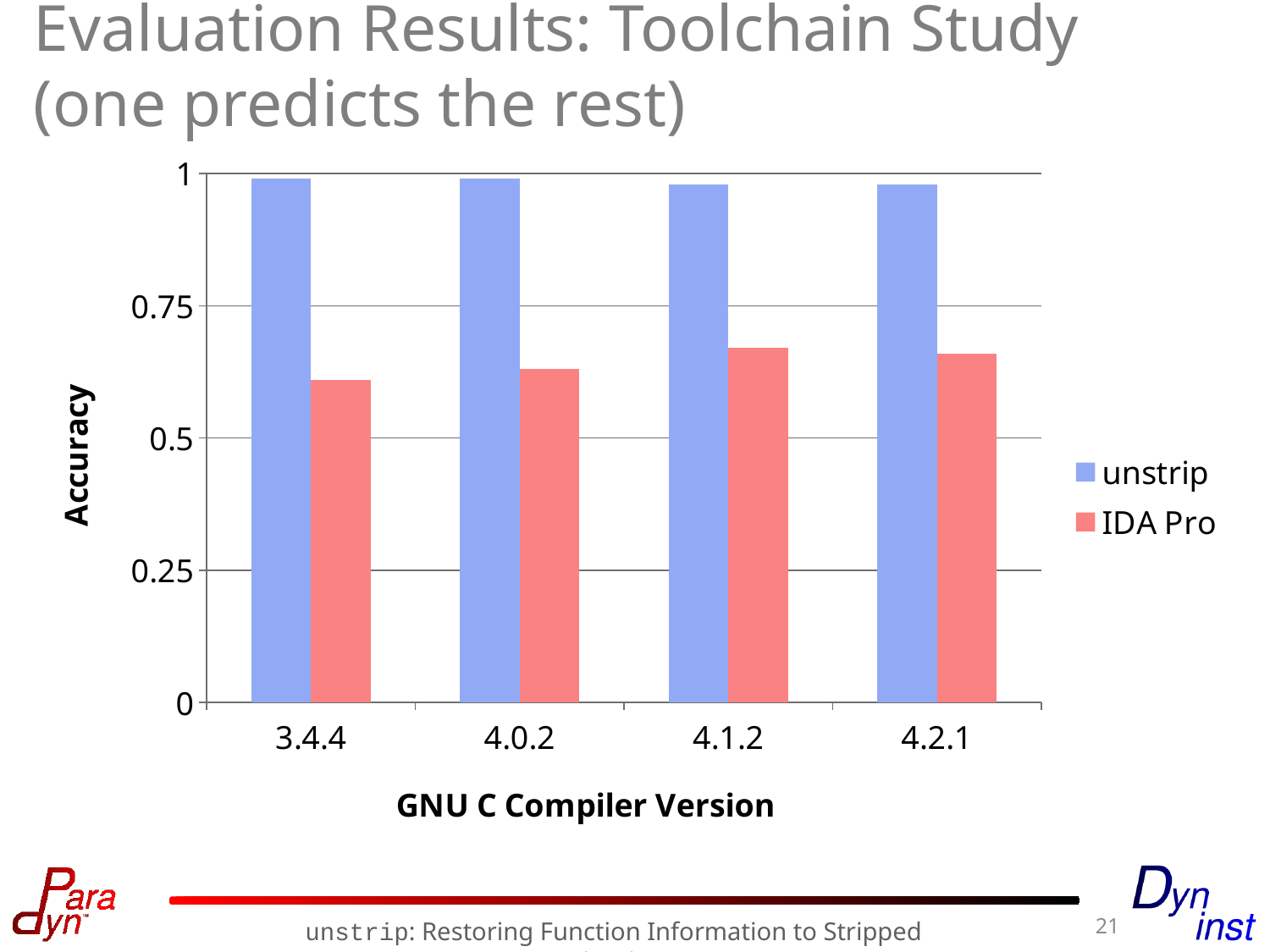
What kind of chart is shown on the slide? bar chart Which series has the higher accuracy for compiler version 3.4.4, unstrip or IDA Pro? unstrip Which series has the lower accuracy for compiler version 4.2.1, unstrip or IDA Pro? IDA Pro Is the IDA Pro accuracy for version 3.4.4 greater or less than 0.75? less What is the label of the y axis? Accuracy Is the IDA Pro accuracy for version 4.1.2 greater or less than 0.5? greater How many series does the legend list? 2 Is the IDA Pro accuracy for version 4.2.1 greater or less than 0.75? less What is the label of the x axis? GNU C Compiler Version How many GNU C Compiler versions are shown on the x axis? 4